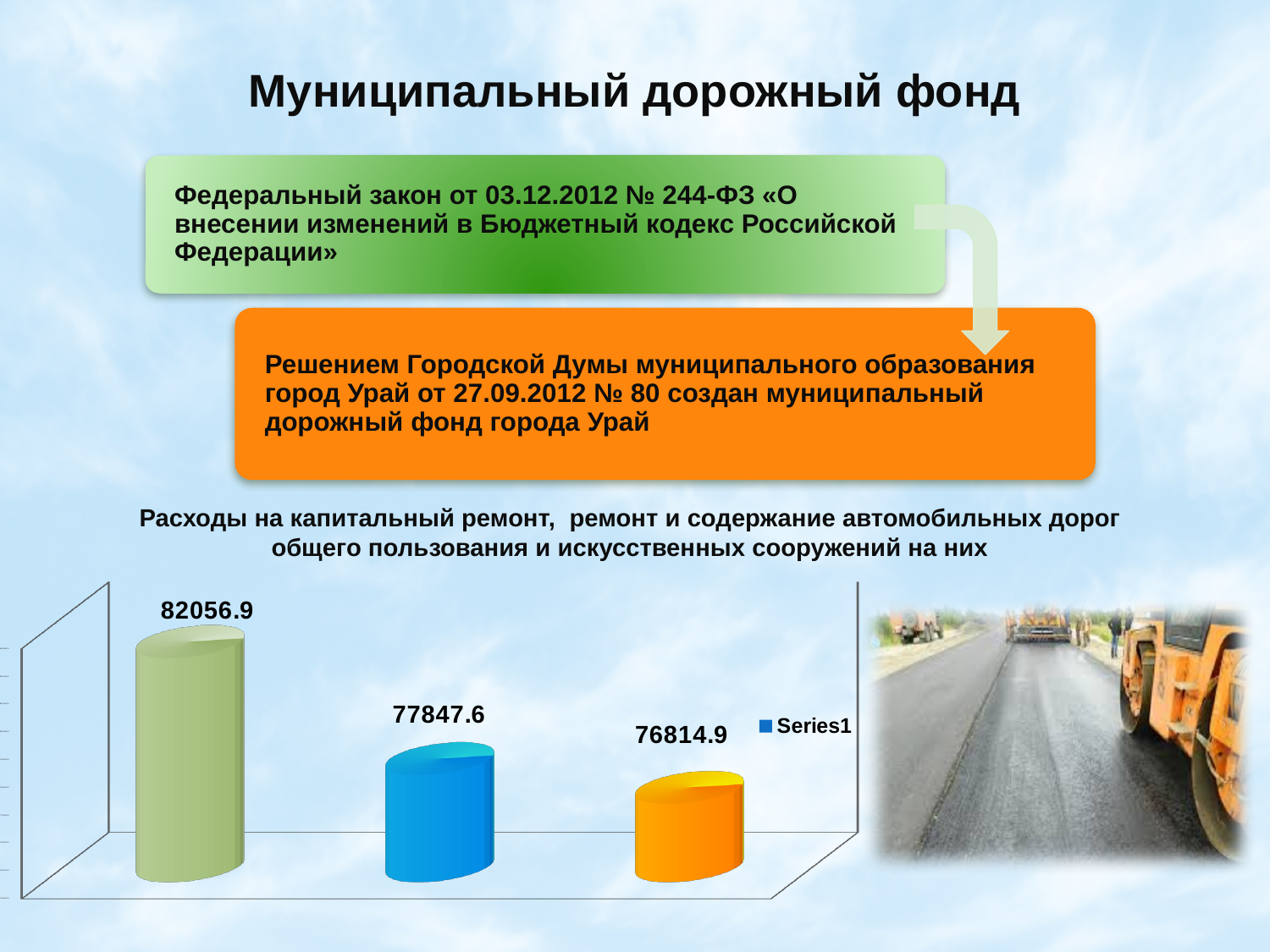
Which is larger: the value of the middle bar or the value of the rightmost bar? The middle bar (77847.6) Do the values rise or fall from left to right across the chart? Fall How many bars are plotted in the chart? 3 Which bar in the chart has the lowest value? The rightmost (orange) bar, 76814.9 What is the difference between the middle bar (77847.6) and the rightmost bar (76814.9)? 1032.7 What value is shown on the data label of the rightmost (orange) bar in the chart? 76814.9 How many series does the chart legend list? 1 What value is shown on the data label of the leftmost (green) bar in the chart? 82056.9 What is the difference between the leftmost bar (82056.9) and the middle bar (77847.6)? 4209.3 What type of chart is shown on the slide? Bar chart Which bar in the chart has the highest value? The leftmost (green) bar, 82056.9 What value is shown on the data label of the middle (blue) bar in the chart? 77847.6